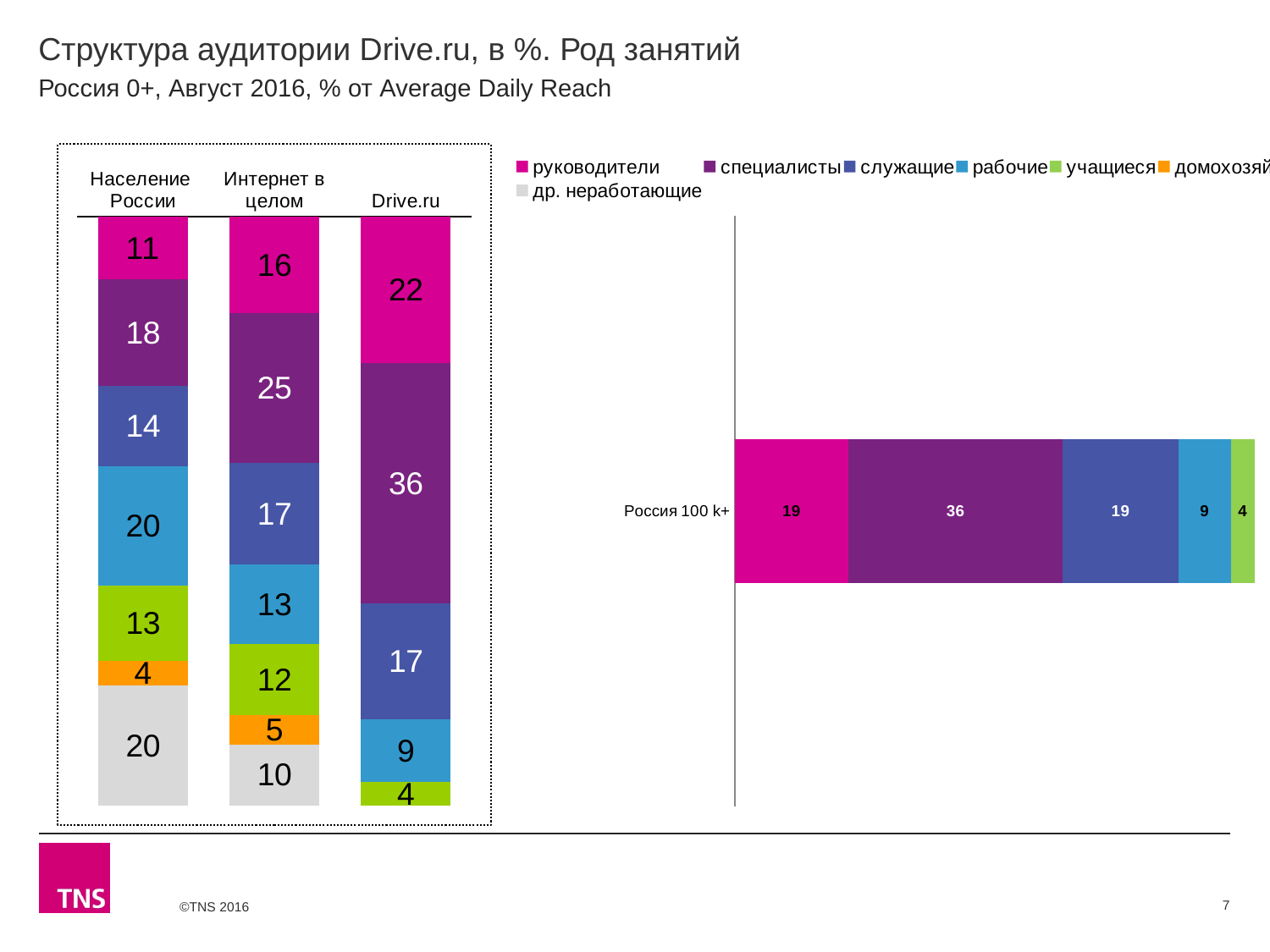
How many series does the legend list? 7 In the left stacked bar chart, what is the difference between the специалисты (purple) values for Drive.ru and Население России? 18 In the right chart for Россия 100 k+, what is the total of all the labelled segments? 87 In the left stacked bar chart, what is the value for руководители (pink) in the Население России bar? 11 In the left stacked bar chart, what is the value for специалисты (purple) in the Drive.ru bar? 36 In the right chart for Россия 100 k+, which segment is the smallest? учащиеся How many bars (categories) are shown in the left stacked bar chart? 3 In the left stacked bar chart, which is larger: the рабочие (light blue) value for Население России or for Drive.ru? Население России In the right chart for Россия 100 k+, what is the value of the специалисты (purple) segment? 36 In the left stacked bar chart, which of the three bars has the largest руководители (pink) segment? Drive.ru What type of chart is the chart on the right labelled Россия 100 k+? Stacked bar chart In the left stacked bar chart, what is the value for др. неработающие (grey) in the Интернет в целом bar? 10